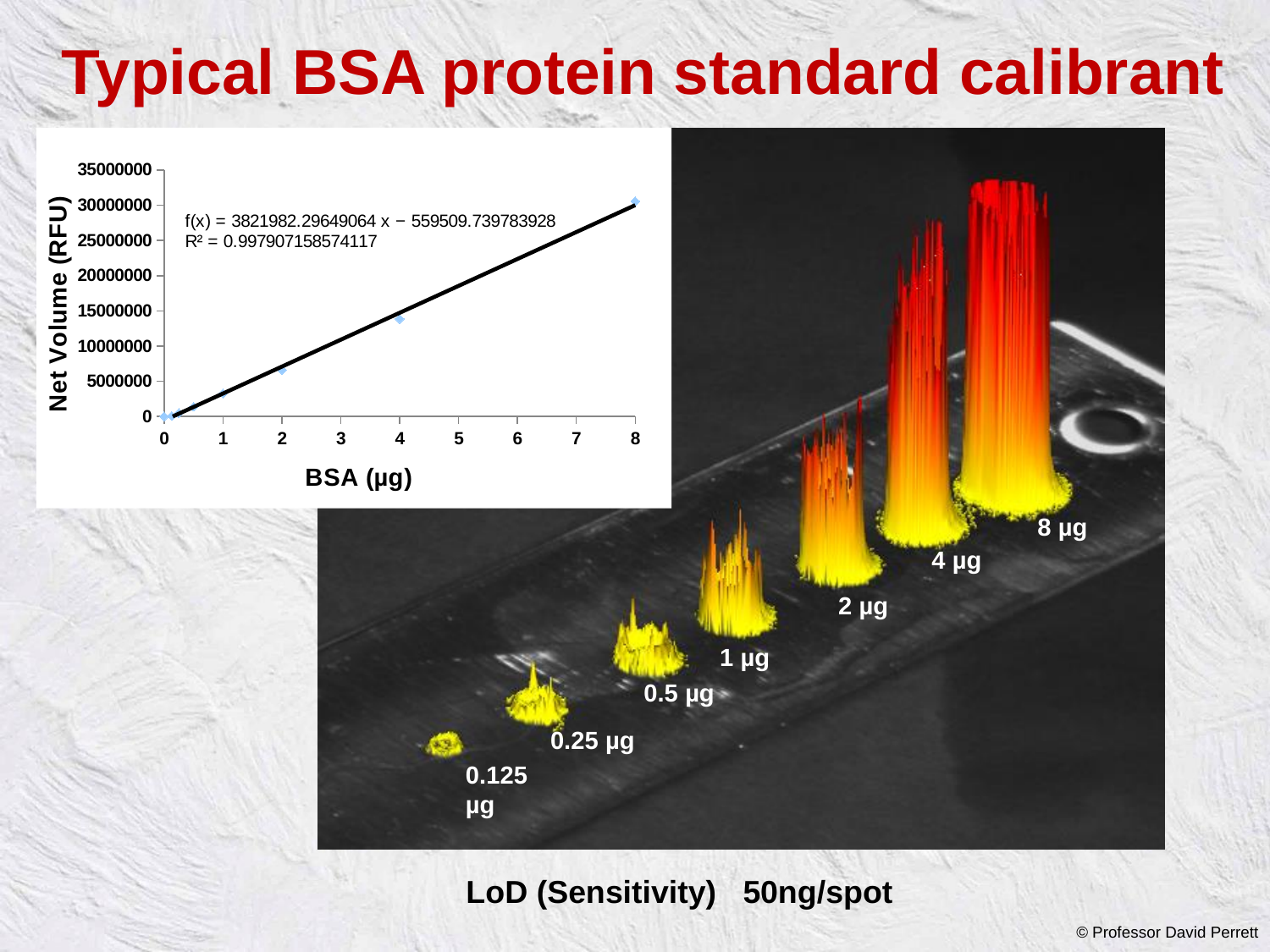
In the chart, is the Net Volume at 4 µg BSA greater or less than 10000000? greater In the chart, do the Net Volume values rise or fall as BSA (µg) increases? rise In the chart, is the Net Volume at 1 µg BSA greater or less than 5000000? less In the chart, at which BSA amount is the Net Volume highest? 8 µg What R² value is printed on the chart? 0.997907158574117 What is the highest value shown on the y axis of the chart? 35000000 In the chart, is the Net Volume at 2 µg BSA greater or less than 5000000? greater What kind of chart is shown on the left of the slide? scatter chart with a linear trendline In the chart, which has the larger Net Volume: 4 µg BSA or 2 µg BSA? 4 µg BSA